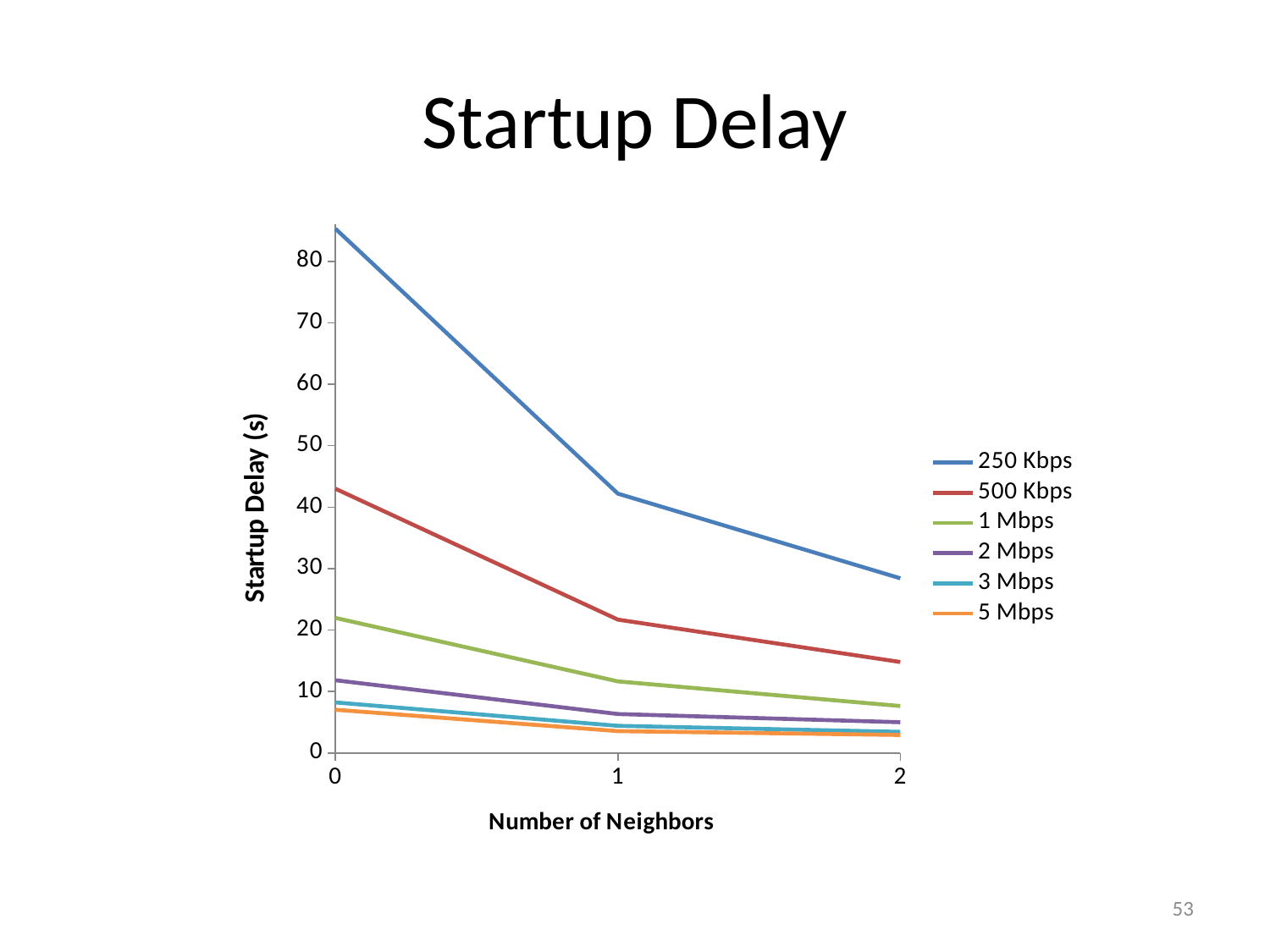
Is the startup delay for 500 Kbps at 0 neighbors greater or less than 50? less Is the startup delay for 1 Mbps at 0 neighbors greater or less than 30? less How many values of Number of Neighbors are plotted along the x axis? 3 What is the label of the y axis? Startup Delay (s) Does the startup delay for 250 Kbps rise or fall as the number of neighbors increases? fall Is the startup delay for 250 Kbps at 1 neighbor greater or less than 50? less Which series has the lowest startup delay at 0 neighbors? 5 Mbps What kind of chart is shown on the slide? line chart Which is larger at 2 neighbors, the startup delay for 500 Kbps or for 1 Mbps? 500 Kbps How many series does the legend list? 6 Which series has the highest startup delay at 0 neighbors? 250 Kbps